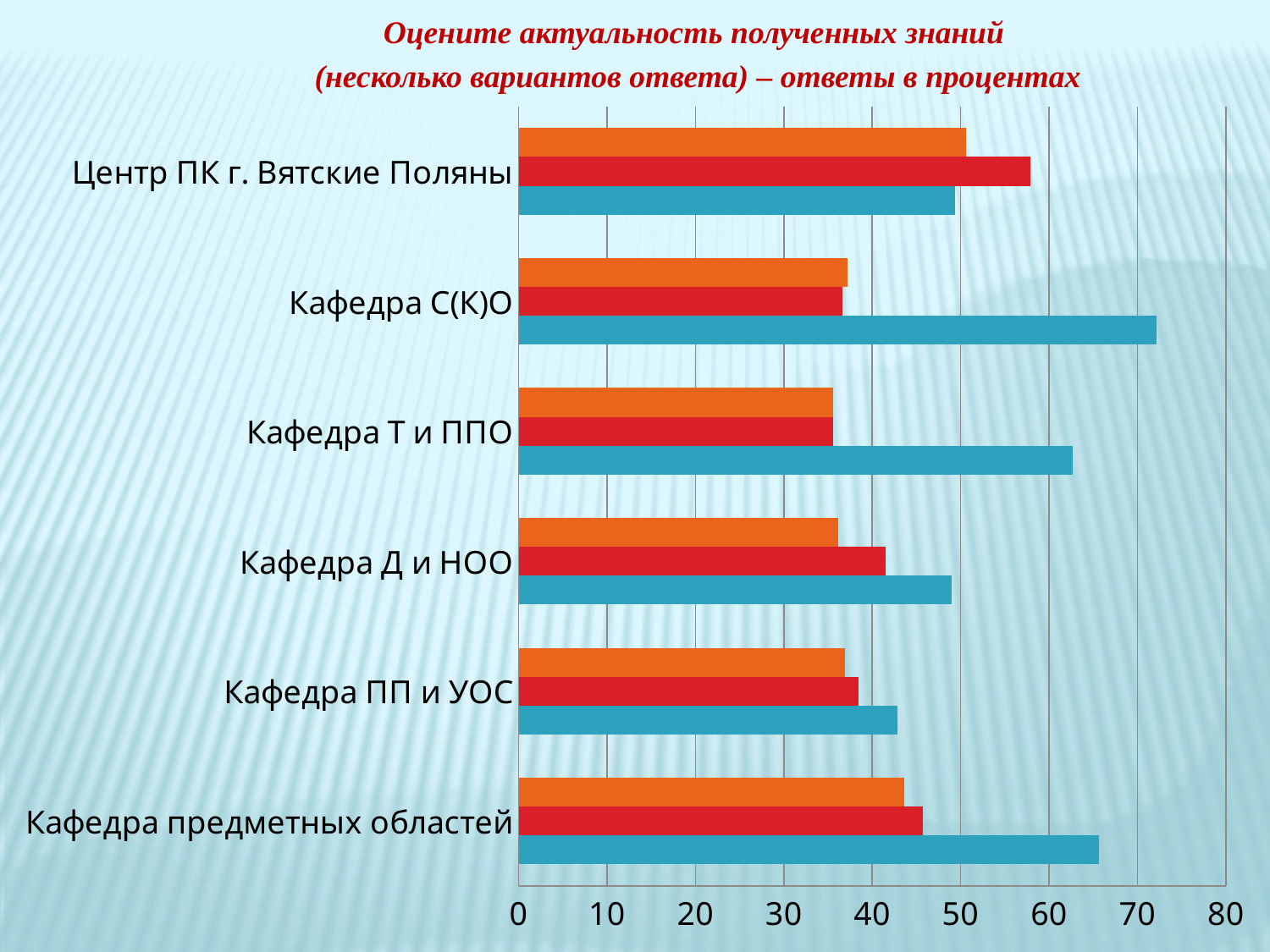
How many categories (departments) are shown on the chart? 6 Is the value of the blue bar for Кафедра предметных областей greater or less than 60? greater Which is larger: the red bar for Центр ПК г. Вятские Поляны or the red bar for Кафедра С(К)О? Центр ПК г. Вятские Поляны Is the value of the blue bar for Кафедра Т и ППО greater or less than 60? greater Is the value of the blue bar for Кафедра С(К)О greater or less than 70? greater What is the maximum value shown on the horizontal axis of the chart? 80 Which category has the longest blue bar? Кафедра С(К)О How many bars are plotted for each category on the chart? 3 What kind of chart is shown on the slide? bar chart